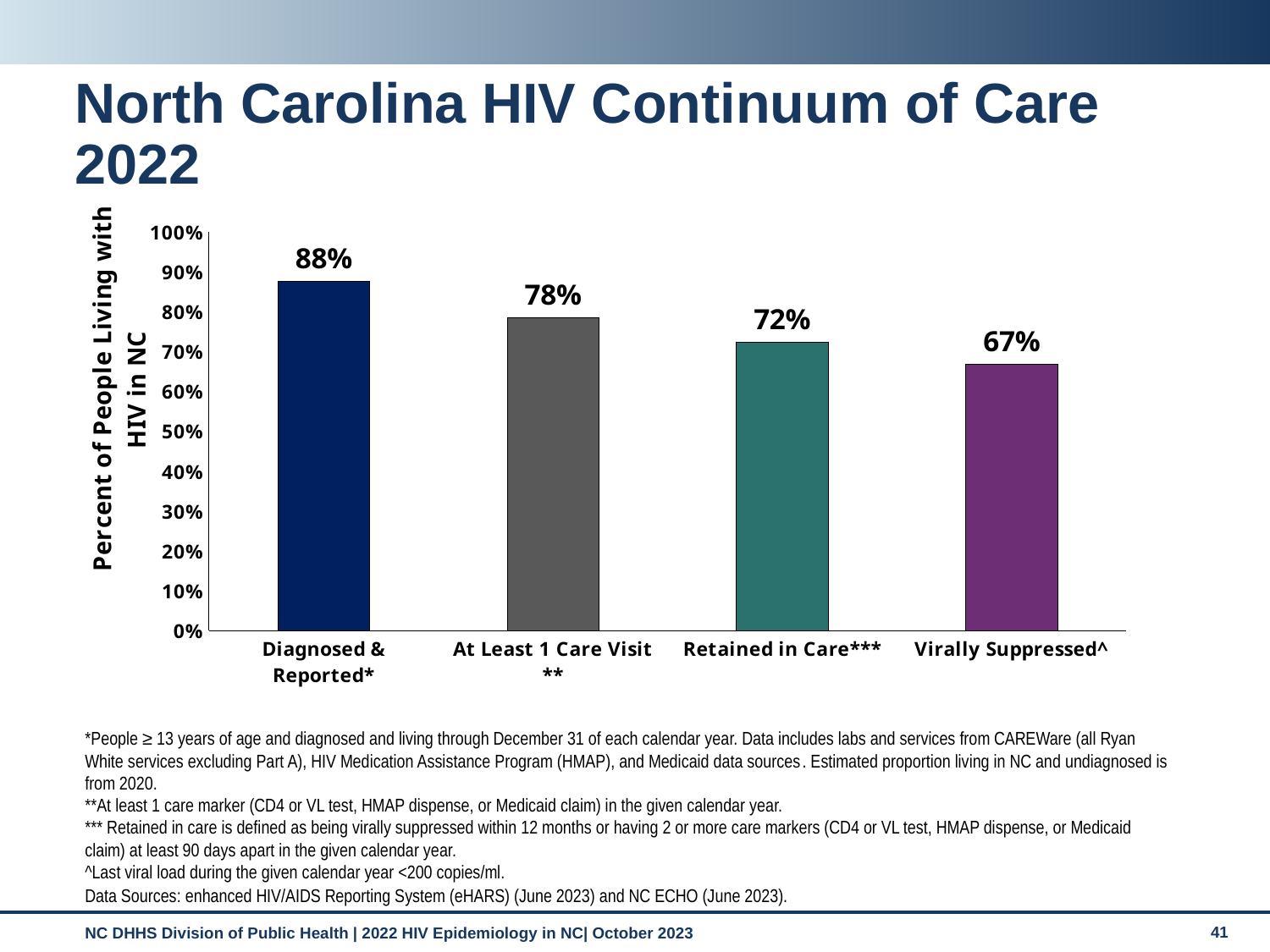
What is the value for At Least 1 Care Visit**? 78% What kind of chart is this? Bar chart What is the difference between Diagnosed & Reported* and Virally Suppressed^? 21% Which category has the highest value? Diagnosed & Reported* Which is larger, Retained in Care*** or Virally Suppressed^? Retained in Care*** What percentage is shown for Retained in Care***? 72% What is the difference between At Least 1 Care Visit** and Retained in Care***? 6% How many categories are shown on the chart? 4 What percentage is shown for Diagnosed & Reported*? 88% What is the value for Virally Suppressed^? 67% Do the values rise or fall from left to right across the categories? Fall Which category has the lowest value? Virally Suppressed^